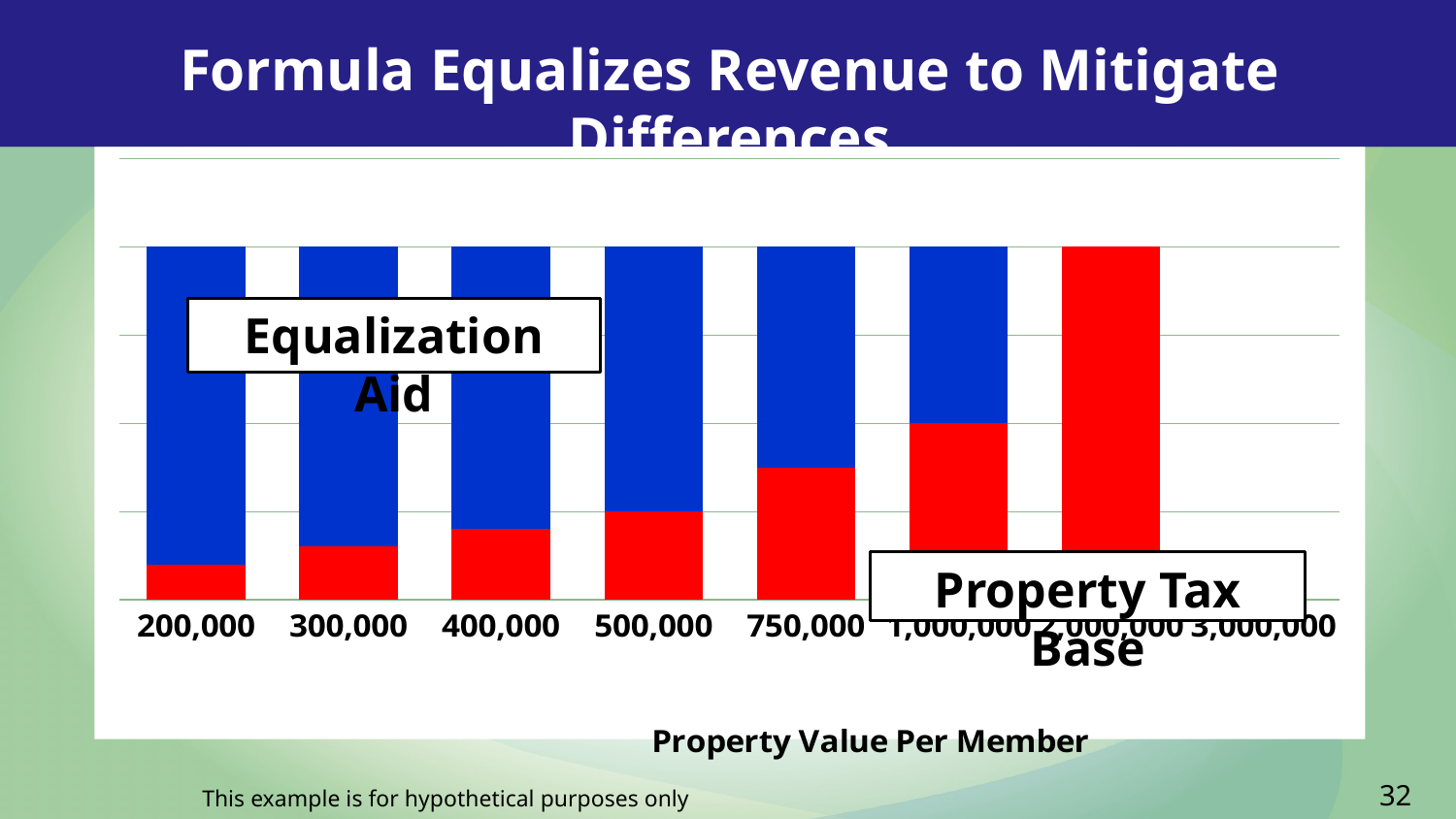
Which has the larger Property Tax Base portion, the 500,000 category or the 1,000,000 category? 1,000,000 What is the title of the x axis? Property Value Per Member How many property value categories are shown along the x axis? 8 Which category has the largest Equalization Aid (blue) portion? 200,000 Which category has the largest Property Tax Base (red) portion? 2,000,000 What are the two series labelled in the chart? Equalization Aid and Property Tax Base Which category has the smallest Property Tax Base (red) portion? 200,000 Does the Equalization Aid portion rise or fall as property value per member increases along the x axis? Falls Which category receives no Equalization Aid? 2,000,000 How many series are shown in the chart? 2 What kind of chart is shown on the slide? Stacked bar chart Does the Property Tax Base portion rise or fall as property value per member increases along the x axis? Rises